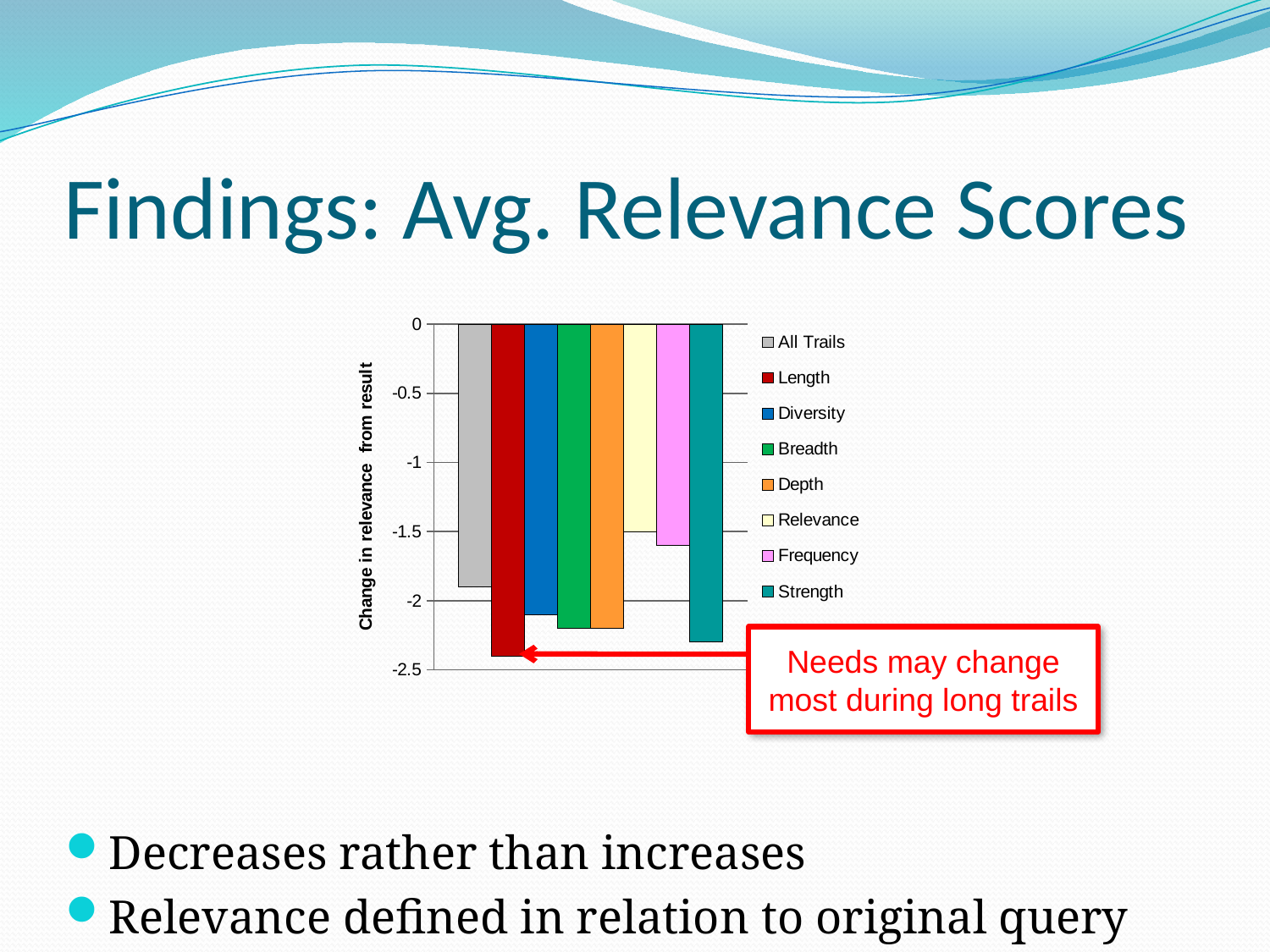
What kind of chart is shown on the slide? bar chart Is the value for Breadth greater or less than -2? less What is the title of the vertical axis? Change in relevance from result Is the value for Frequency greater or less than -2? greater Which is larger, the value for Relevance or the value for Strength? Relevance Which series has the lowest (most negative) change in relevance? Length How many series does the legend list? 8 Is the value for Strength greater or less than -2? less Which is larger, the value for All Trails or the value for Length? All Trails How many bars are plotted in the chart? 8